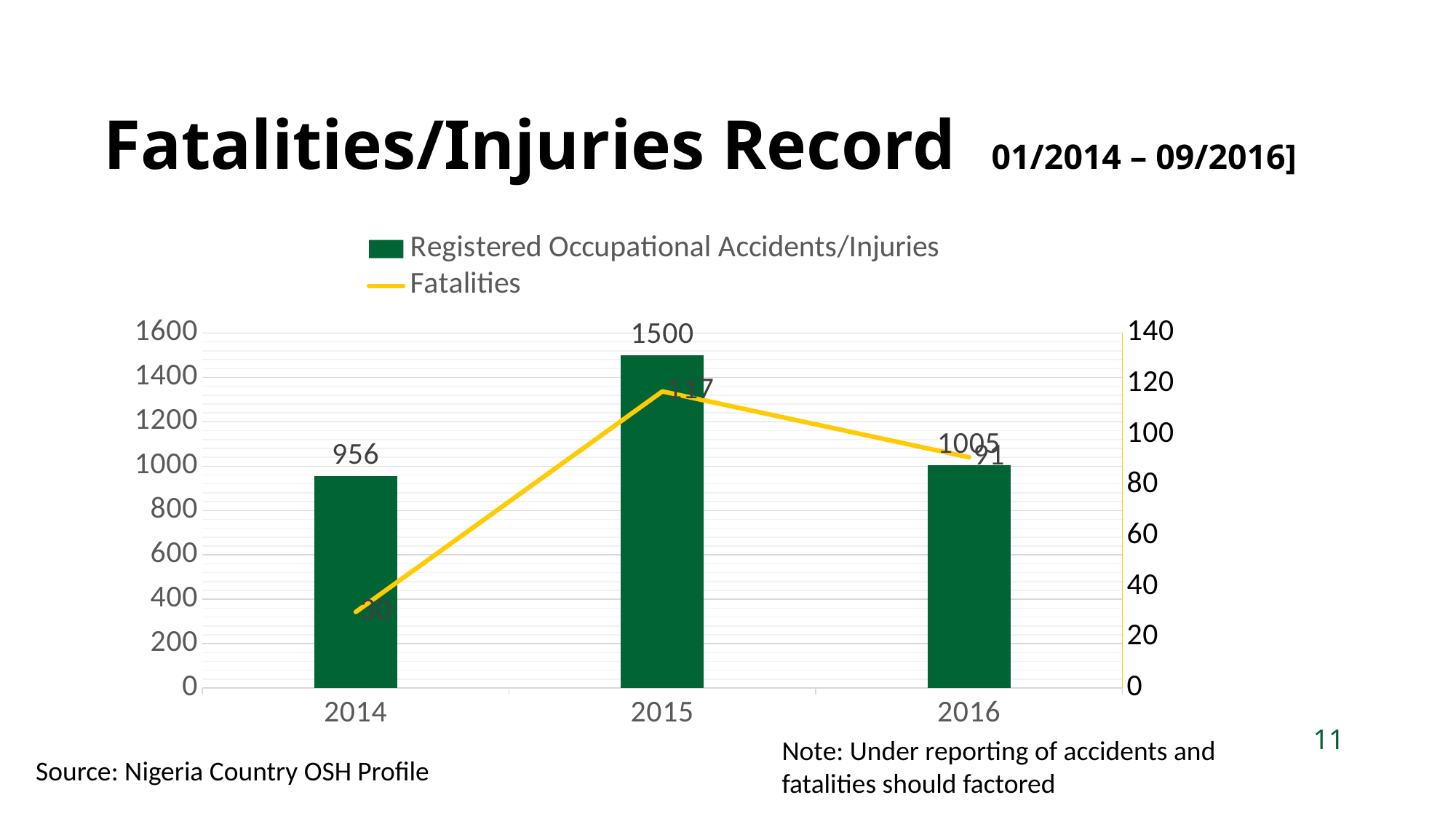
What is the value of Registered Occupational Accidents/Injuries for 2015? 1500 How many series does the chart legend list? 2 Which year has the lowest number of Registered Occupational Accidents/Injuries? 2014 What is the value of Registered Occupational Accidents/Injuries for 2014? 956 How many Fatalities are recorded for 2015? 117 What is the difference in Registered Occupational Accidents/Injuries between 2015 and 2014? 544 How many Fatalities are recorded for 2016? 91 Which year has the highest number of Registered Occupational Accidents/Injuries? 2015 Is the Fatalities value for 2014 greater or less than 40? less What is the value of Registered Occupational Accidents/Injuries for 2016? 1005 How many years are shown on the x axis of the chart? 3 Which year has more Fatalities, 2015 or 2016? 2015